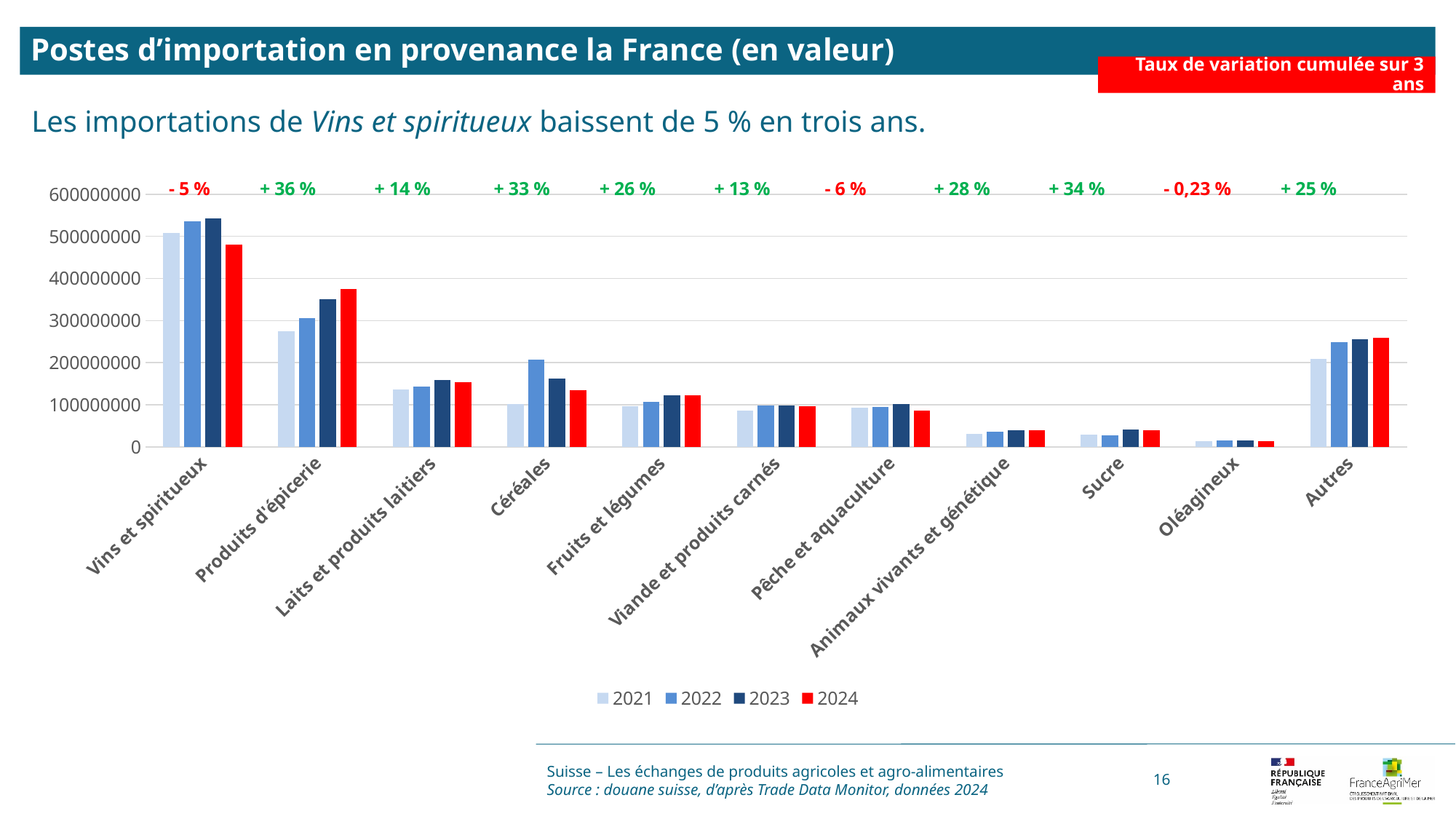
Which category has the highest import values across the years? Vins et spiritueux How many series does the legend list? 4 Which category shows the most negative cumulative variation rate printed above the bars? Pêche et aquaculture What is the cumulative variation rate over 3 years printed above Produits d'épicerie? + 36 % Which category has the lowest import values across the years? Oléagineux Is the 2021 value for Produits d'épicerie greater or less than 300000000? less What is the cumulative variation rate over 3 years printed above Céréales? + 33 % How many product categories are shown on the x axis? 11 What is the cumulative variation rate over 3 years printed above Oléagineux? - 0,23 % For Céréales, which is larger: the 2022 value or the 2024 value? 2022 What kind of chart is shown on the slide? bar chart Is the 2024 value for Vins et spiritueux greater or less than 400000000? greater